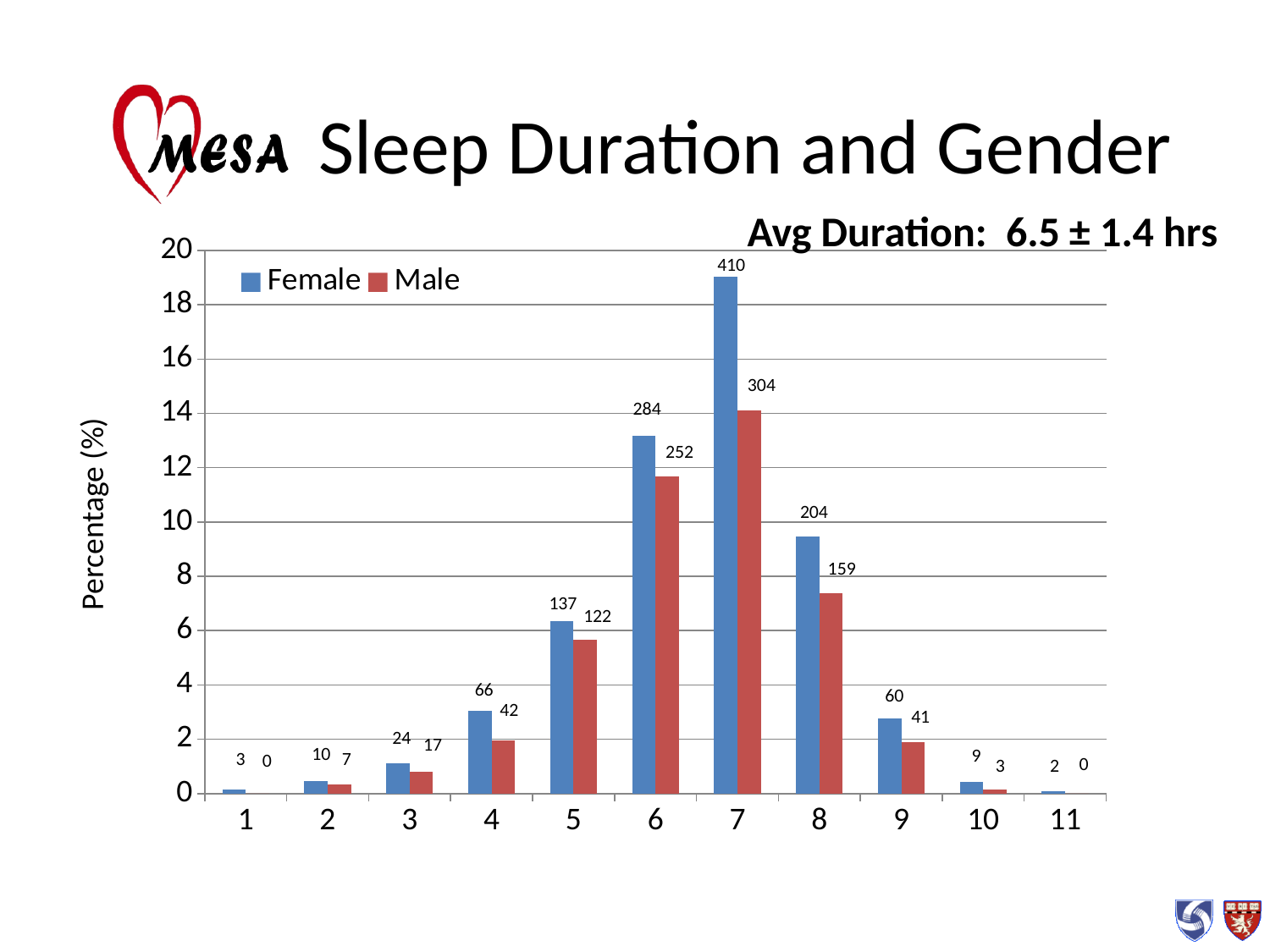
How many categories are shown along the x axis? 11 Which category has the lowest Male bar? 1 and 11 Which category has the highest Female bar? 7 What average duration is stated on the slide? 6.5 ± 1.4 hrs What is the data label on the Female bar for category 7? 410 What is the data label on the Male bar for category 6? 252 How many series does the legend list? 2 What is the difference between the Female and Male data labels for category 7? 106 What is the data label on the Male bar for category 8? 159 Is the Female value for category 7 greater or less than 18? greater What type of chart is shown on the slide? bar chart For category 5, which bar is taller, Female or Male? Female